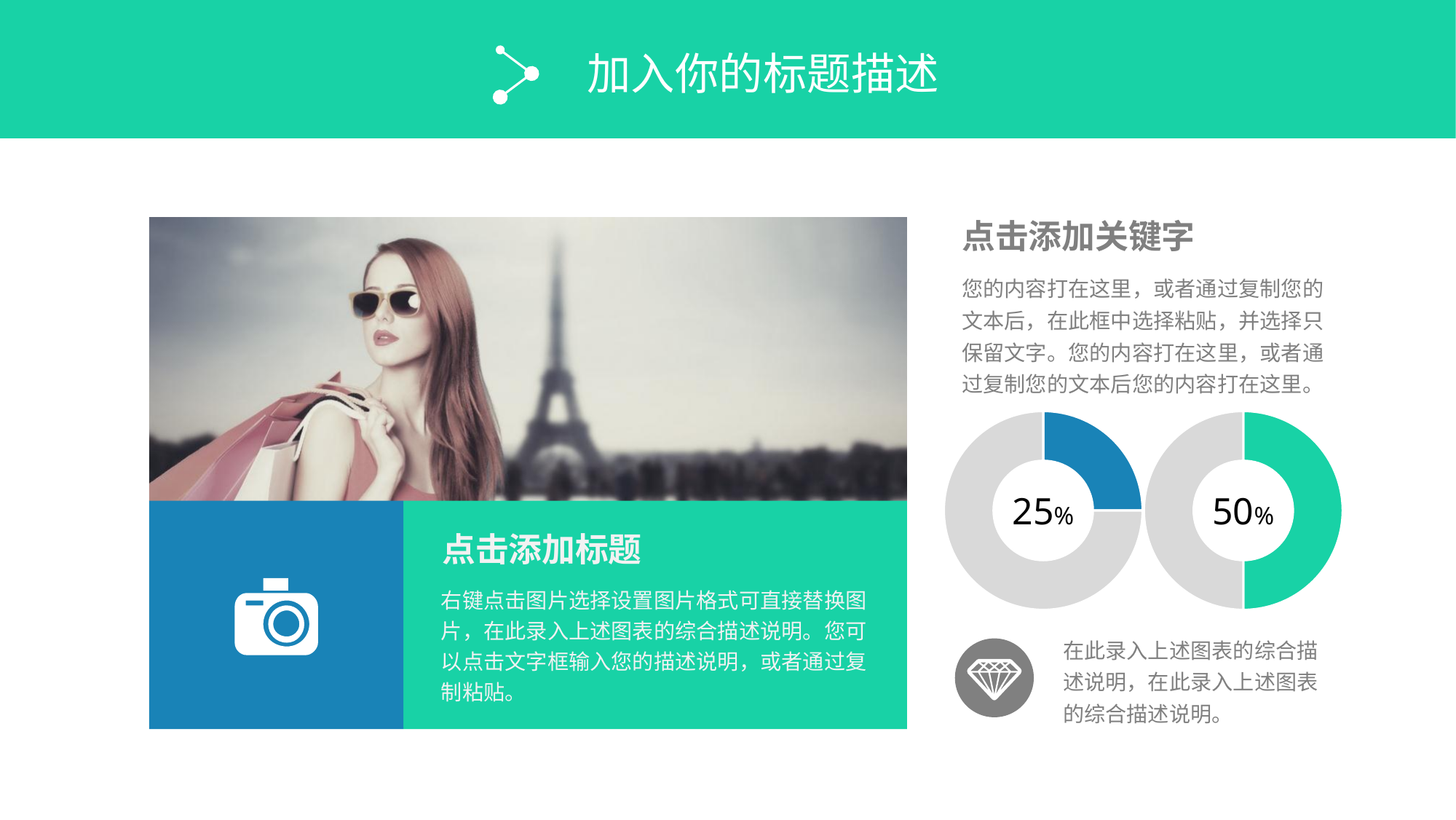
What kind of chart is the right chart on the right side of the slide? doughnut chart What is the difference between the percentage in the right doughnut chart and the percentage in the left doughnut chart? 25% How many doughnut charts are on the slide? 2 What kind of chart is the left chart on the right side of the slide? doughnut chart In the left doughnut chart, what share of the ring is filled in blue? 25% What percentage is shown in the centre of the left doughnut chart? 25% Which doughnut chart shows the larger percentage, the left one or the right one? the right one What colour is the filled segment of the left doughnut chart? blue What colour is the filled segment of the right doughnut chart? green What percentage is shown in the centre of the right doughnut chart? 50% In the right doughnut chart, what share of the ring is filled in green? 50%